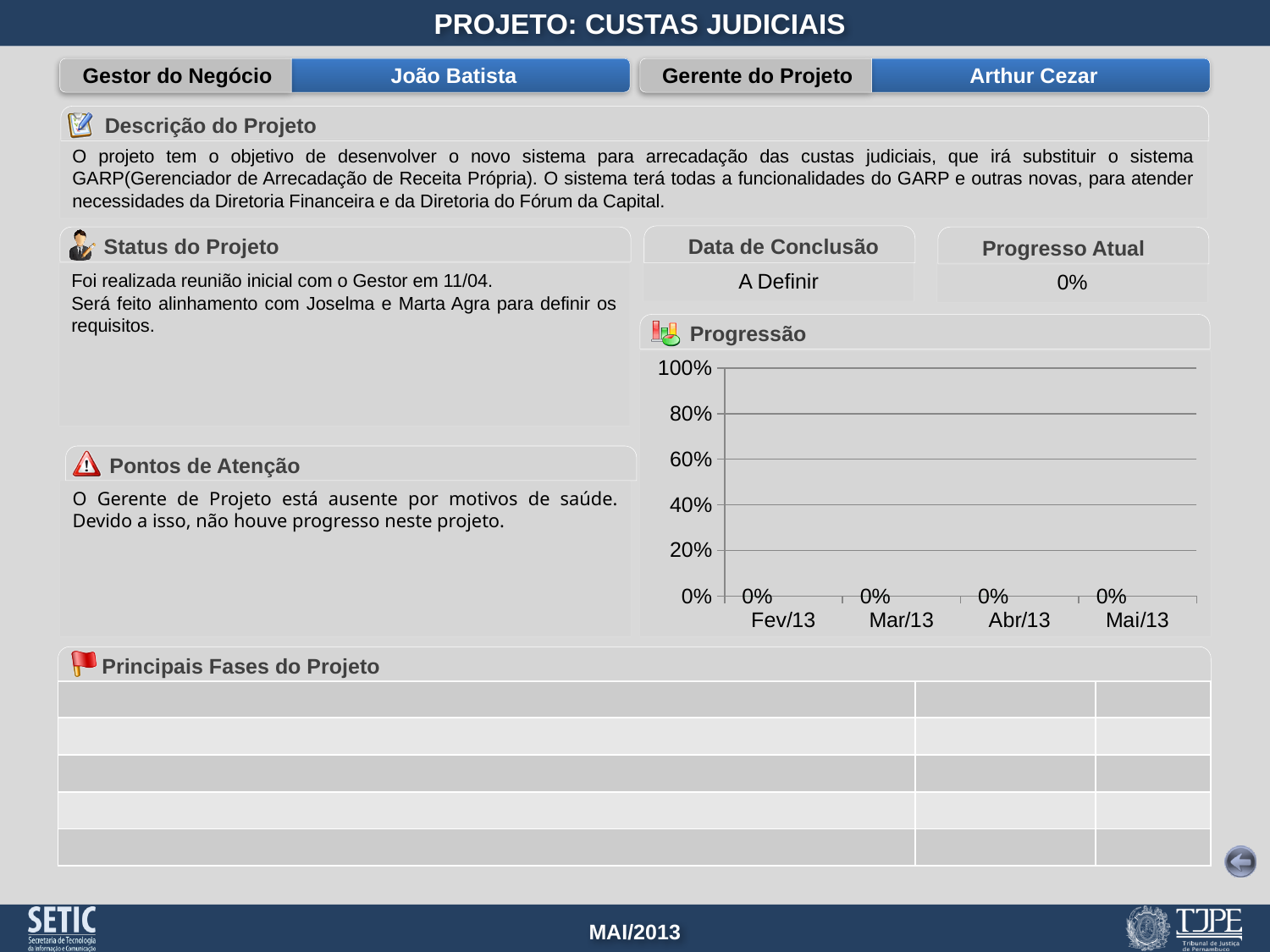
Is the value for Abr/13 in the Progressão chart greater or less than 20%? less What is the title of the chart on the slide? Progressão What is the highest value shown on the y axis of the Progressão chart? 100% How many categories are shown on the x axis of the Progressão chart? 4 Do the values in the Progressão chart rise, fall, or stay flat from Fev/13 to Mai/13? stay flat What is the first category on the x axis of the Progressão chart? Fev/13 In the Progressão chart, what is the value for Mai/13? 0% In the Progressão chart, what is the value for Abr/13? 0% In the Progressão chart, what is the value for Fev/13? 0% In the Progressão chart, what is the difference between the values for Mai/13 and Fev/13? 0% In the Progressão chart, what is the value for Mar/13? 0%